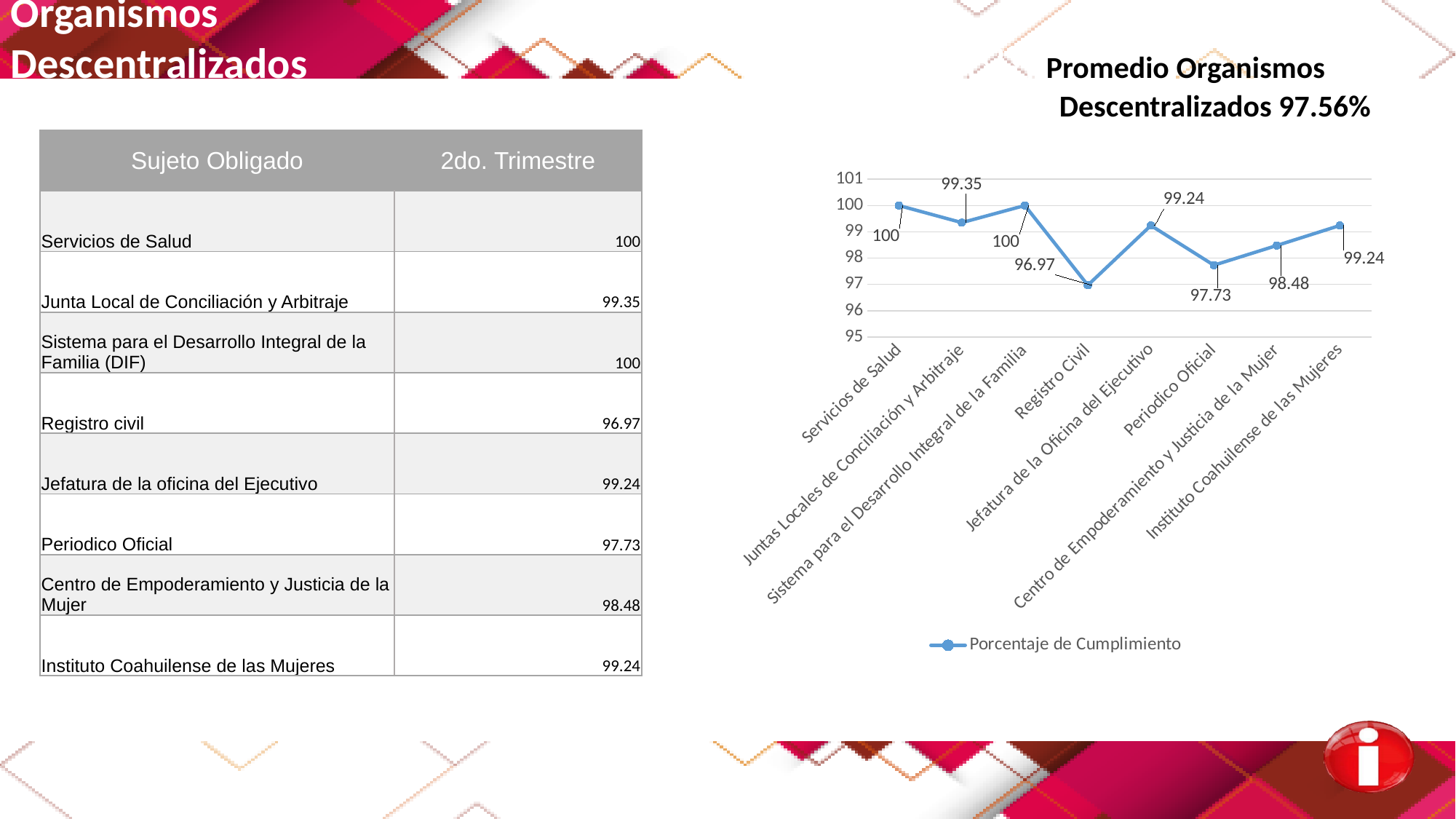
Is the value for Periodico Oficial greater or less than 97? greater What kind of chart is shown on the slide? line chart What is the difference between the value for Servicios de Salud and the value for Registro Civil? 3.03 Which category has the lowest value in the chart? Registro Civil How many series does the chart legend list? 1 How many categories are plotted on the x axis of the chart? 8 What is the value for Periodico Oficial in the chart? 97.73 What is the value for Juntas Locales de Conciliación y Arbitraje in the chart? 99.35 What is the name of the series shown in the chart legend? Porcentaje de Cumplimiento Which is larger, the value for Periodico Oficial or the value for Centro de Empoderamiento y Justicia de la Mujer? Centro de Empoderamiento y Justicia de la Mujer What is the value for Registro Civil in the chart? 96.97 What is the value for Centro de Empoderamiento y Justicia de la Mujer in the chart? 98.48